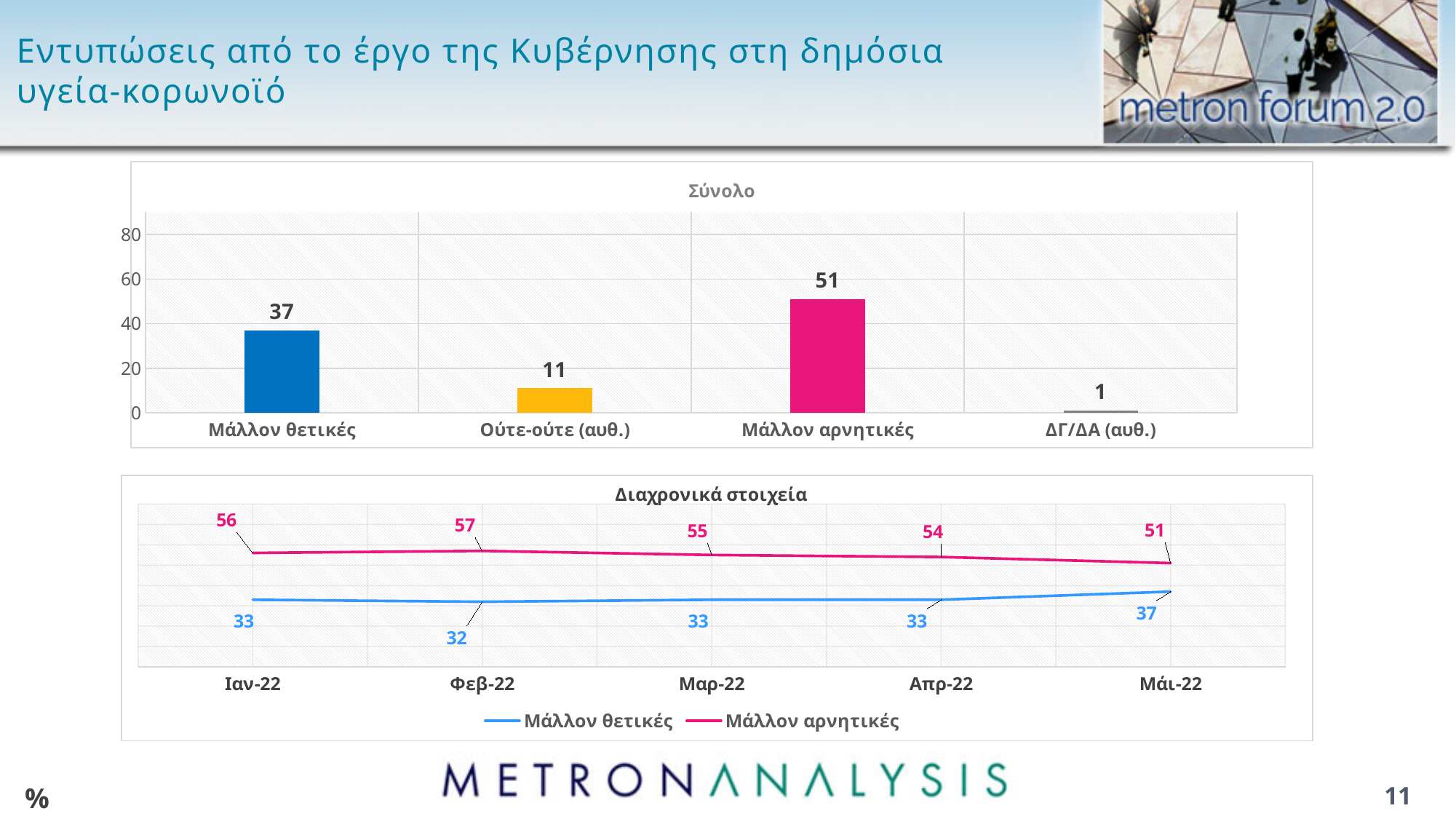
What kind of chart is the 'Διαχρονικά στοιχεία' chart? line chart In the 'Σύνολο' chart, which category has the lowest value? ΔΓ/ΔΑ (αυθ.) In the 'Διαχρονικά στοιχεία' chart, what is the value for 'Μάλλον θετικές' in Μάι-22? 37 In the 'Σύνολο' chart, what is the value for 'Μάλλον αρνητικές'? 51 In the 'Διαχρονικά στοιχεία' chart, what is the value for 'Μάλλον αρνητικές' in Φεβ-22? 57 In the 'Σύνολο' chart, what is the difference between 'Μάλλον αρνητικές' and 'Μάλλον θετικές'? 14 In the 'Διαχρονικά στοιχεία' chart, what is the difference between 'Μάλλον αρνητικές' and 'Μάλλον θετικές' in Ιαν-22? 23 What kind of chart is the 'Σύνολο' chart? bar chart In the 'Διαχρονικά στοιχεία' chart, does 'Μάλλον αρνητικές' rise or fall from Φεβ-22 to Μάι-22? fall In the 'Διαχρονικά στοιχεία' chart, in which month is 'Μάλλον αρνητικές' highest? Φεβ-22 In the 'Σύνολο' chart, how many categories are shown? 4 In the 'Διαχρονικά στοιχεία' chart, how many series does the legend list? 2